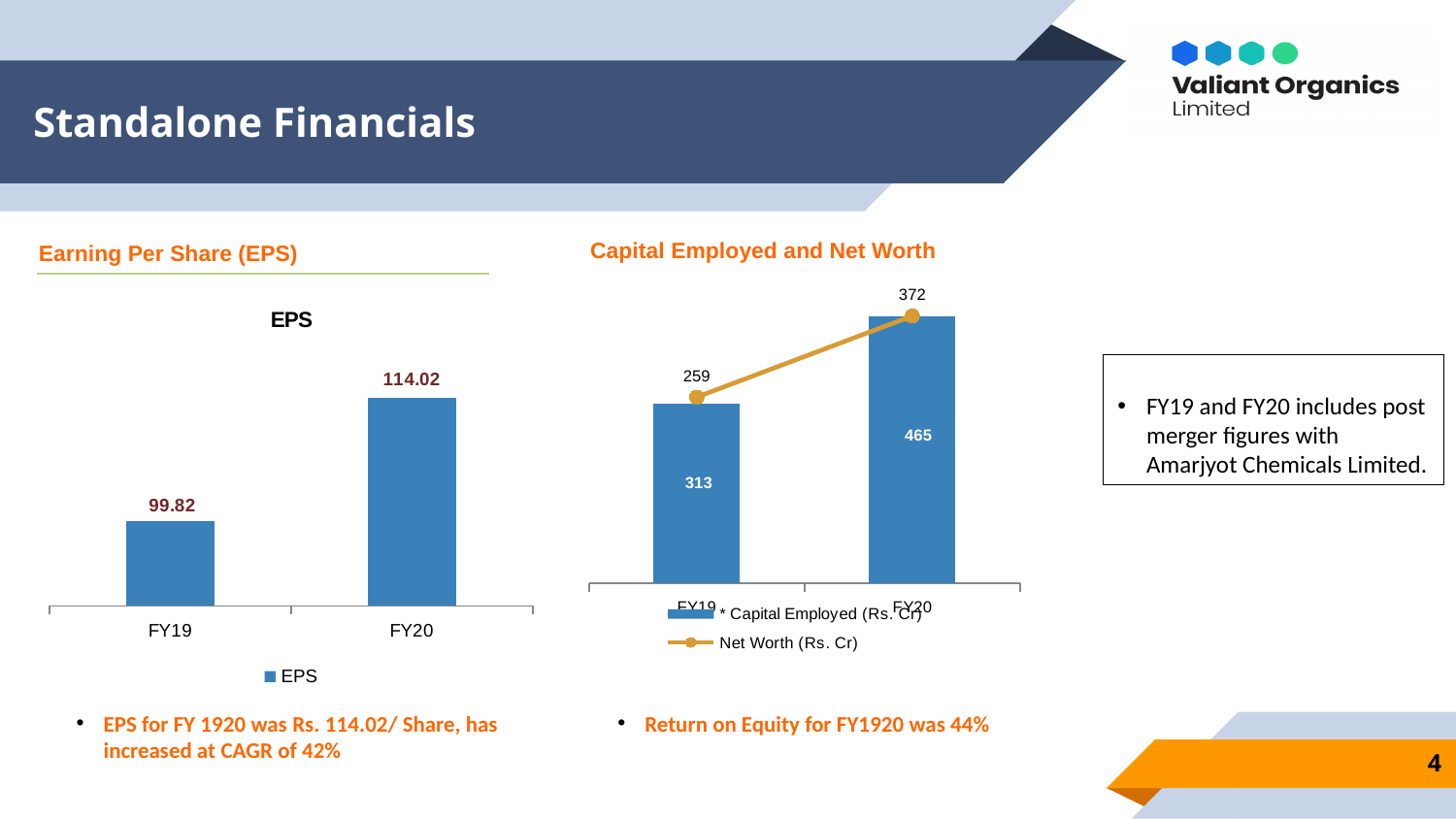
In the EPS chart, what is the EPS value for FY19? 99.82 In the Capital Employed and Net Worth chart, does Net Worth rise or fall from FY19 to FY20? Rise In the Capital Employed and Net Worth chart, which is larger for FY20: Capital Employed or Net Worth? Capital Employed In the Capital Employed and Net Worth chart, what is the Capital Employed (Rs. Cr) for FY20? 465 In the Capital Employed and Net Worth chart, what is the Net Worth (Rs. Cr) for FY19? 259 What kind of chart is the EPS chart? Bar chart In the Capital Employed and Net Worth chart, what is the difference in Capital Employed between FY20 and FY19? 152 In the EPS chart, which year has the higher EPS? FY20 In the EPS chart, what is the EPS value for FY20? 114.02 In the EPS chart, how many years are shown on the x axis? 2 In the Capital Employed and Net Worth chart, how many series does the legend list? 2 In the EPS chart, by how much did EPS increase from FY19 to FY20? 14.2